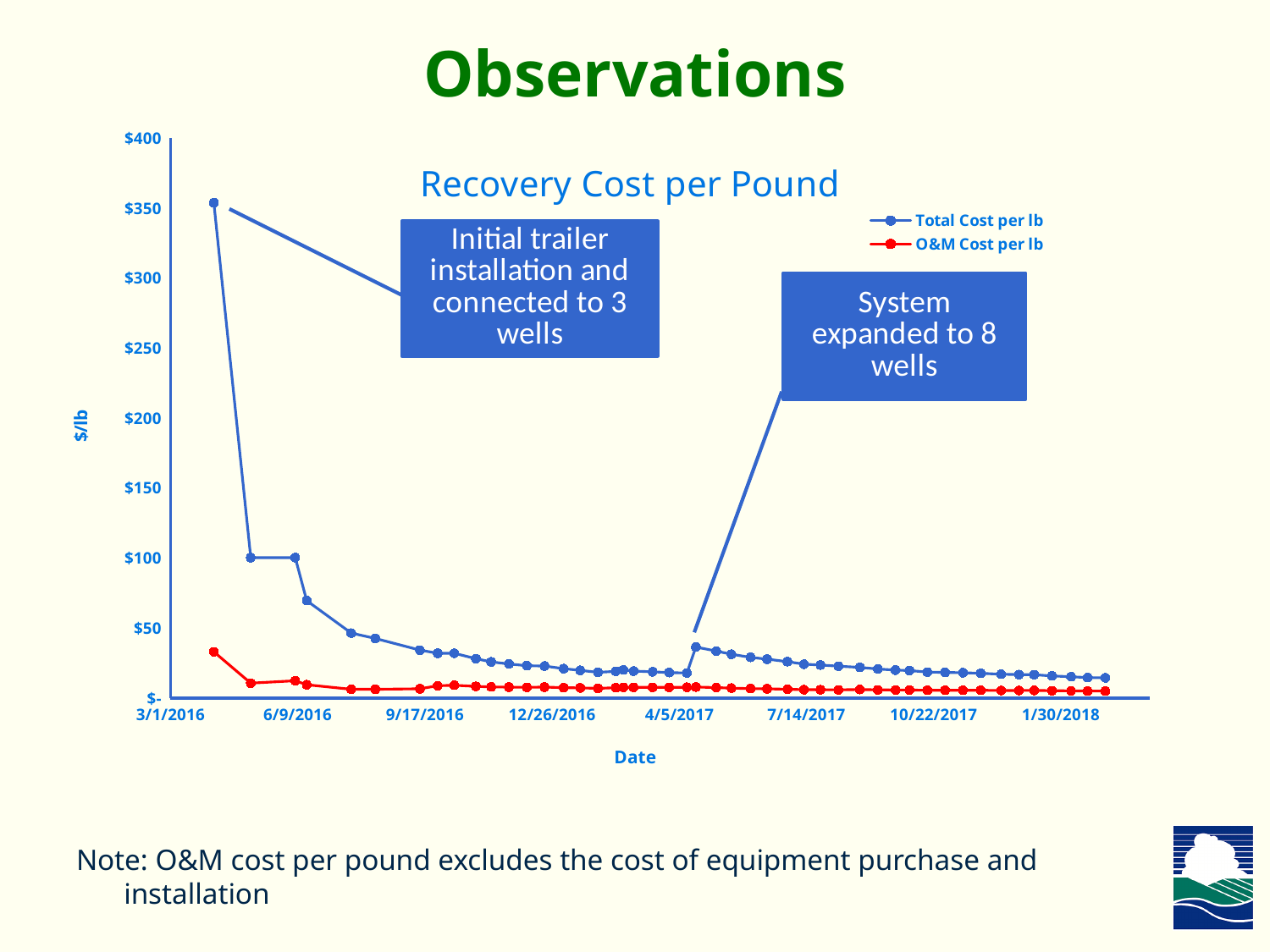
How many series does the legend list? 2 Does the Total Cost per lb series generally rise or fall from the first date to the last date? fall Which series has the higher value at the first plotted date, Total Cost per lb or O&M Cost per lb? Total Cost per lb Is the first plotted value of O&M Cost per lb greater or less than $50? less What is the title of the chart? Recovery Cost per Pound Is the value of Total Cost per lb at the last date greater or less than the value of O&M Cost per lb at the last date? greater What are the two series named in the legend? Total Cost per lb and O&M Cost per lb Is the last plotted value of Total Cost per lb greater or less than $50? less What kind of chart is shown on the slide? line chart Which series stays lower across the whole date range? O&M Cost per lb Is the first plotted value of Total Cost per lb greater or less than $300? greater What is the label on the y axis? $/lb